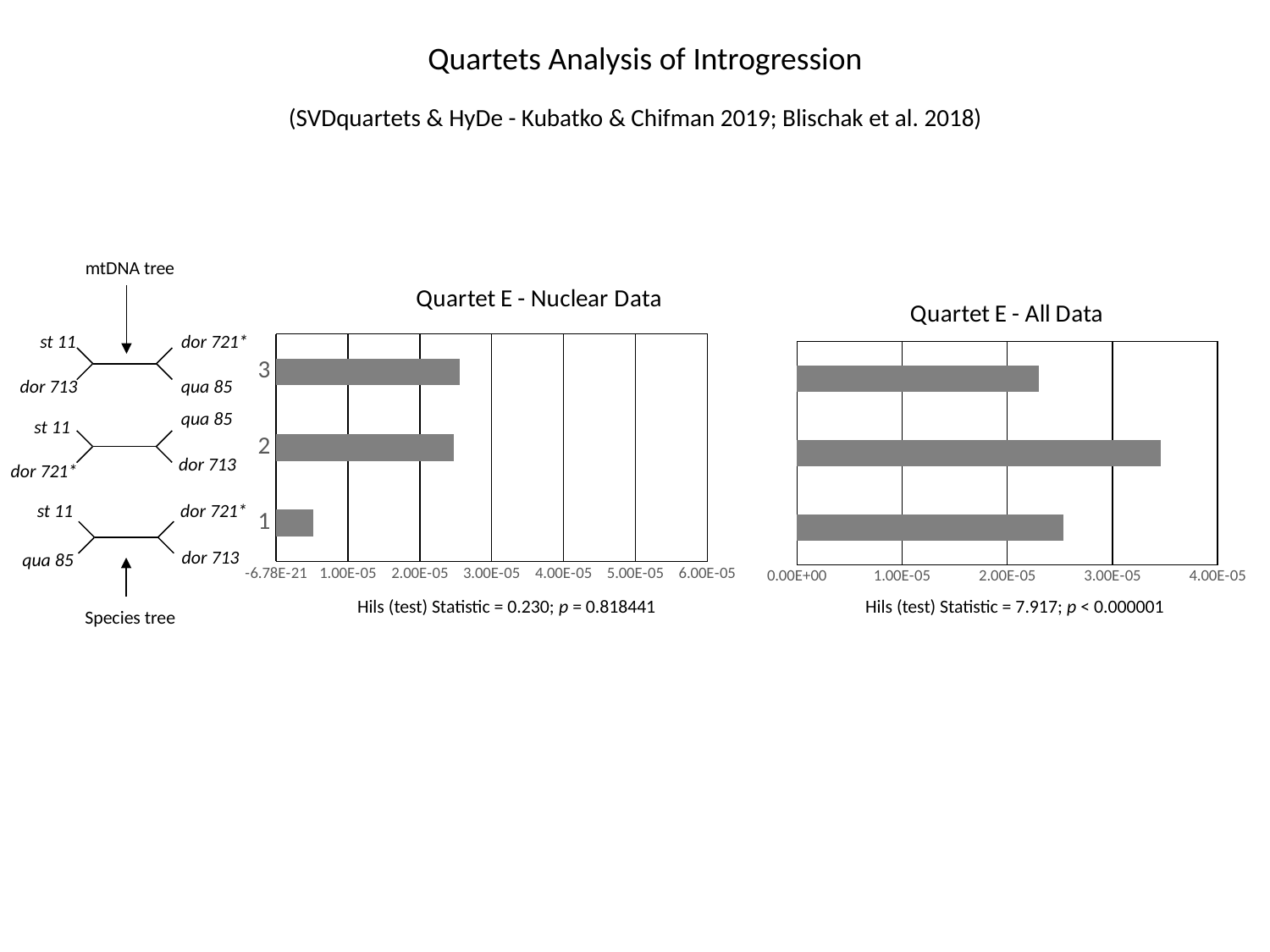
In the 'Quartet E - All Data' chart, how many bars are plotted? 3 In the 'Quartet E - Nuclear Data' chart, what kind of chart is shown? bar chart In the 'Quartet E - Nuclear Data' chart, which category has the lowest value? 1 In the 'Quartet E - Nuclear Data' chart, which is larger, the value for category 3 or category 1? 3 In the 'Quartet E - Nuclear Data' chart, is the value for category 1 greater or less than 1.00E-05? less In the 'Quartet E - All Data' chart, is the value of the top bar greater or less than 3.00E-05? less In the 'Quartet E - Nuclear Data' chart, is the value for category 2 greater or less than 3.00E-05? less What is the title of the chart on the right side of the slide? Quartet E - All Data In the 'Quartet E - Nuclear Data' chart, how many bars are plotted? 3 In the 'Quartet E - All Data' chart, which bar has the highest value? the middle bar